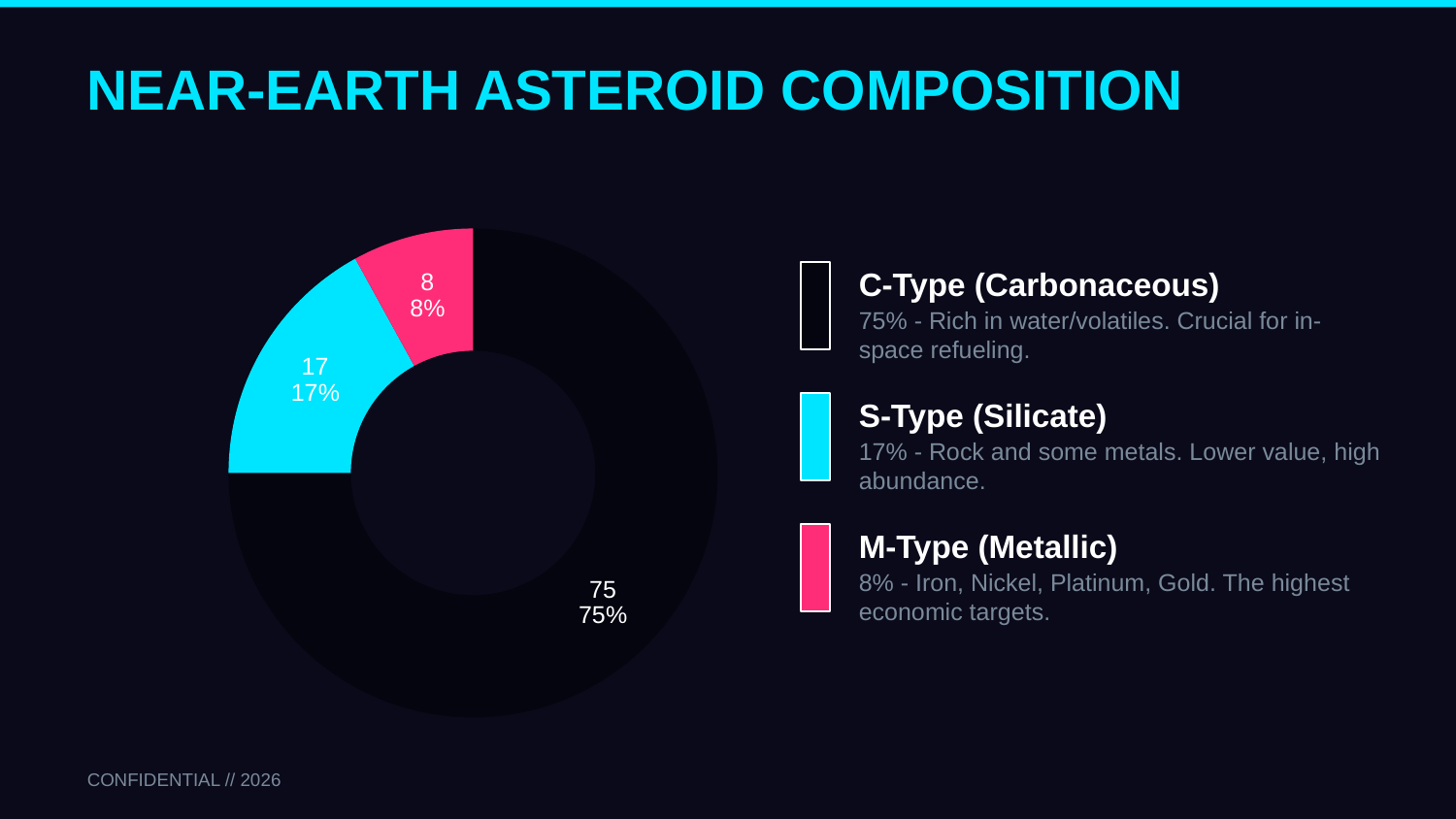
What percentage share does the M-Type (Metallic) slice have? 8% How many slices does the chart have? 3 What percentage share does the S-Type (Silicate) slice have? 17% What kind of chart is shown on the slide? Doughnut chart What is the difference in percentage points between the C-Type and S-Type slices? 58 What colour is the S-Type (Silicate) slice? Cyan What value is printed on the M-Type (Metallic) slice? 8 Which slice is larger, S-Type (Silicate) or M-Type (Metallic)? S-Type (Silicate) Which asteroid type has the smallest slice? M-Type (Metallic) Which asteroid type has the largest slice? C-Type (Carbonaceous) What value is printed on the S-Type (Silicate) slice? 17 What percentage share does the C-Type (Carbonaceous) slice have? 75%